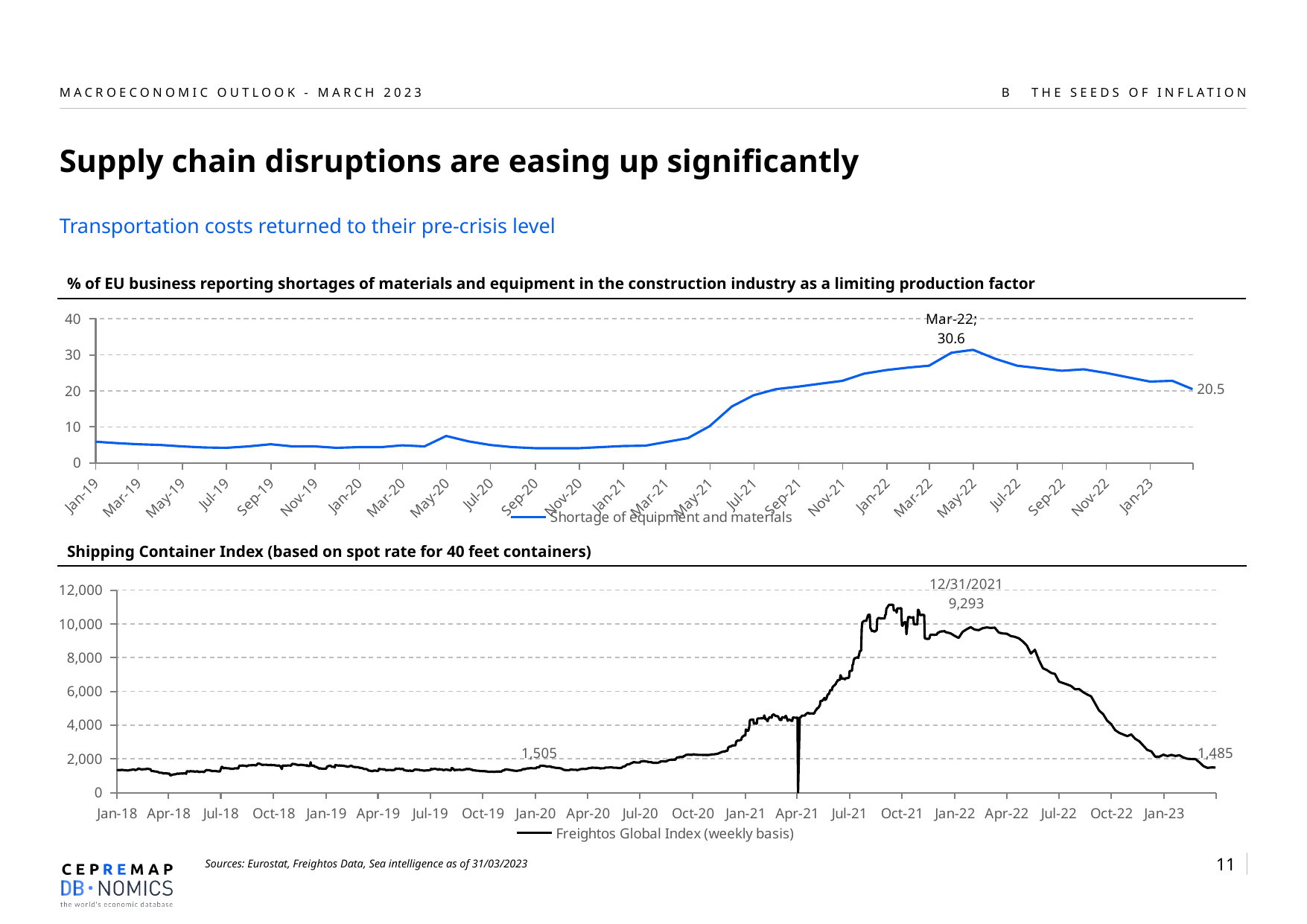
In the top chart on EU business shortages, what value is labelled for Mar-22? 30.6 In the Shipping Container Index chart, is the value for Jan-18 greater or less than 2,000? less In the top chart on EU business shortages, what is the difference between the Mar-22 value and the final labelled value? 10.1 In the top chart on EU business shortages, what is the value labelled at the end of the series? 20.5 In the top chart on EU business shortages, which is larger: the value for Mar-22 or the value for Jan-23? Mar-22 In the Shipping Container Index chart, what is the value labelled at the end of the series? 1,485 In the top chart on EU business shortages, is the value for Jan-19 greater or less than 10? less In the Shipping Container Index chart, what value is labelled for 12/31/2021? 9,293 In the top chart on EU business shortages, is the value for Jan-22 greater or less than 20? greater In the Shipping Container Index chart, what is the difference between the 12/31/2021 value and the final labelled value of 1,485? 7,808 In the Shipping Container Index chart, what series name does the legend show? Freightos Global Index (weekly basis) What kind of chart is the top chart on EU business shortages? line chart